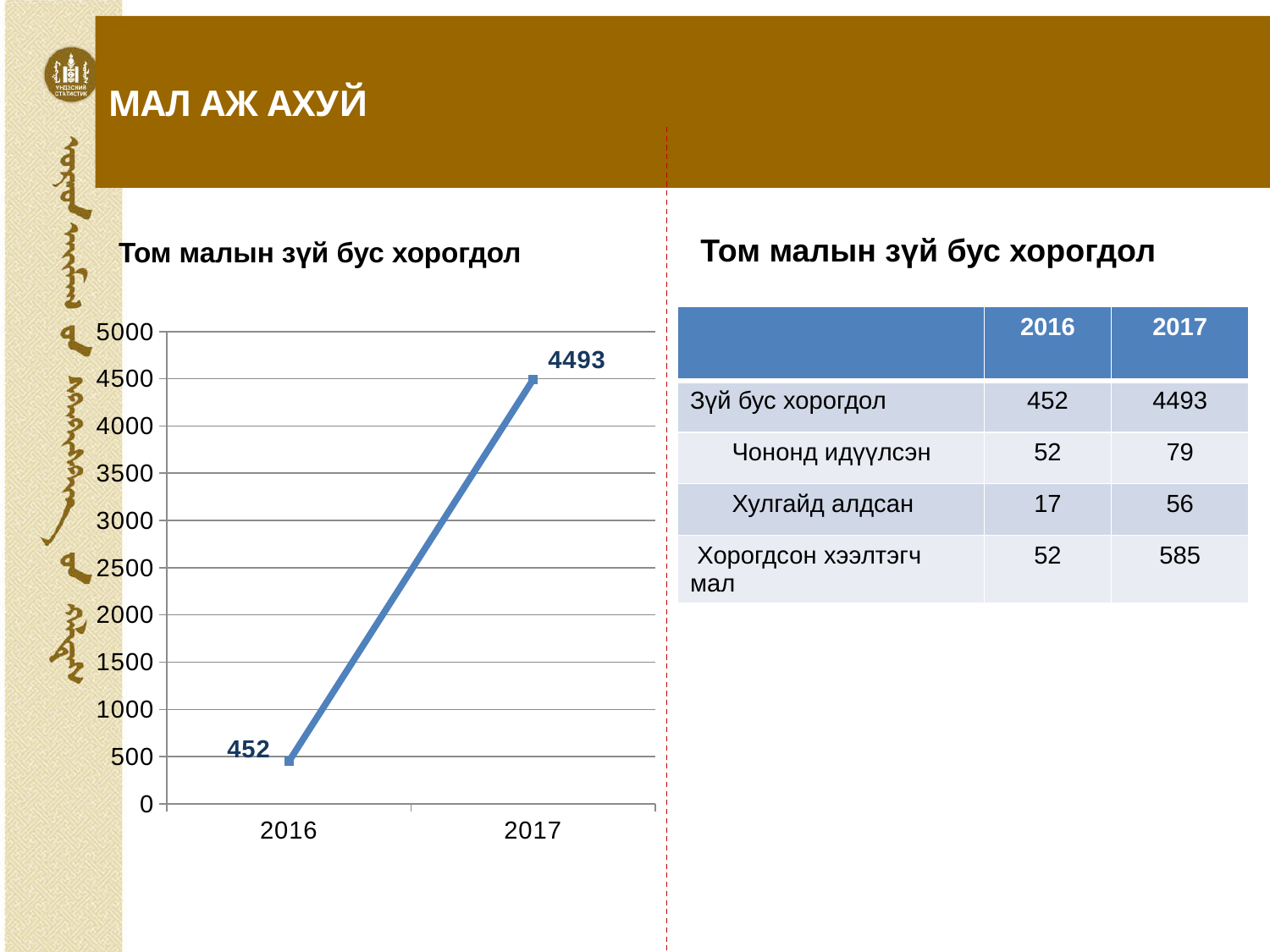
What is the value for 2016 in the chart? 452 Is the value for 2016 in the chart greater or less than 500? less Which year has the lowest value in the chart? 2016 Which is larger in the chart, the value for 2016 or the value for 2017? 2017 What is the difference between the 2017 and 2016 values in the chart? 4041 Is the value for 2017 in the chart greater or less than 4000? greater What kind of chart is shown on the slide? line chart What is the title of the chart? Том малын зүй бус хорогдол Which year has the highest value in the chart? 2017 What is the value for 2017 in the chart? 4493 Do the values in the chart rise or fall from 2016 to 2017? rise How many data points are plotted in the chart? 2